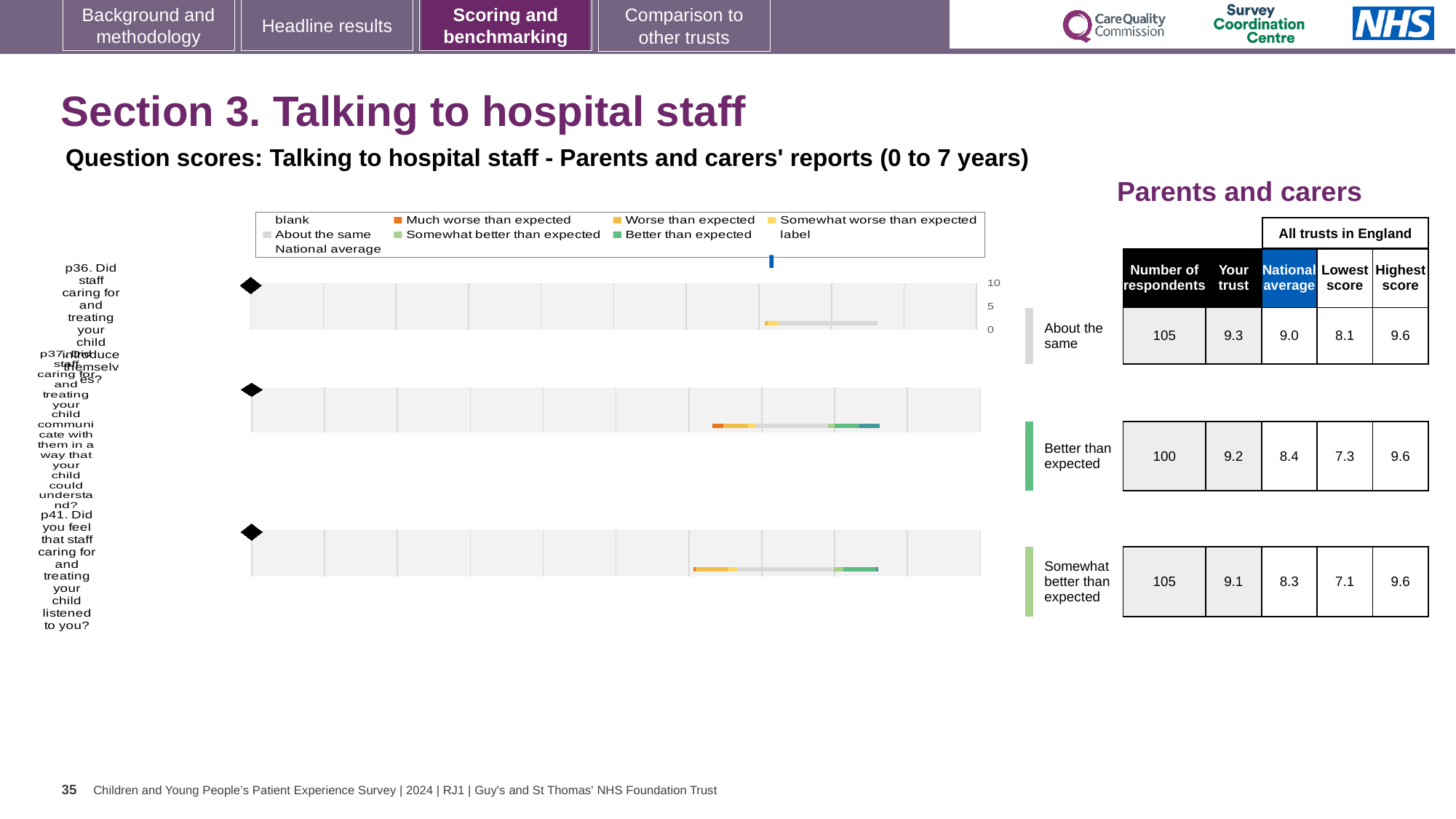
According to the table beside the chart, how many respondents answered p41 (Did you feel that staff caring for and treating your child listened to you)? 105 According to the table beside the chart, what is the national average for p37 (Did staff communicate with them in a way that your child could understand)? 8.4 Which of the three plotted questions has the lowest national average in the table? p41 For p37, which is larger: the 'Your trust' score or the national average? Your trust According to the table beside the chart, what is the 'Your trust' score for p36 (Did staff caring for and treating your child introduce themselves)? 9.3 What kind of chart is used to show the question scores on this slide? bar chart Which of the three plotted questions has the highest 'Your trust' score in the table? p36 What is the difference between the 'Your trust' score and the national average for p36? 0.3 What is the highest value shown on the chart's axis? 10 How many survey questions are plotted in the chart? 3 What benchmark category is shown for p41 next to the chart? Somewhat better than expected Which colour in the legend represents 'Much worse than expected'? orange